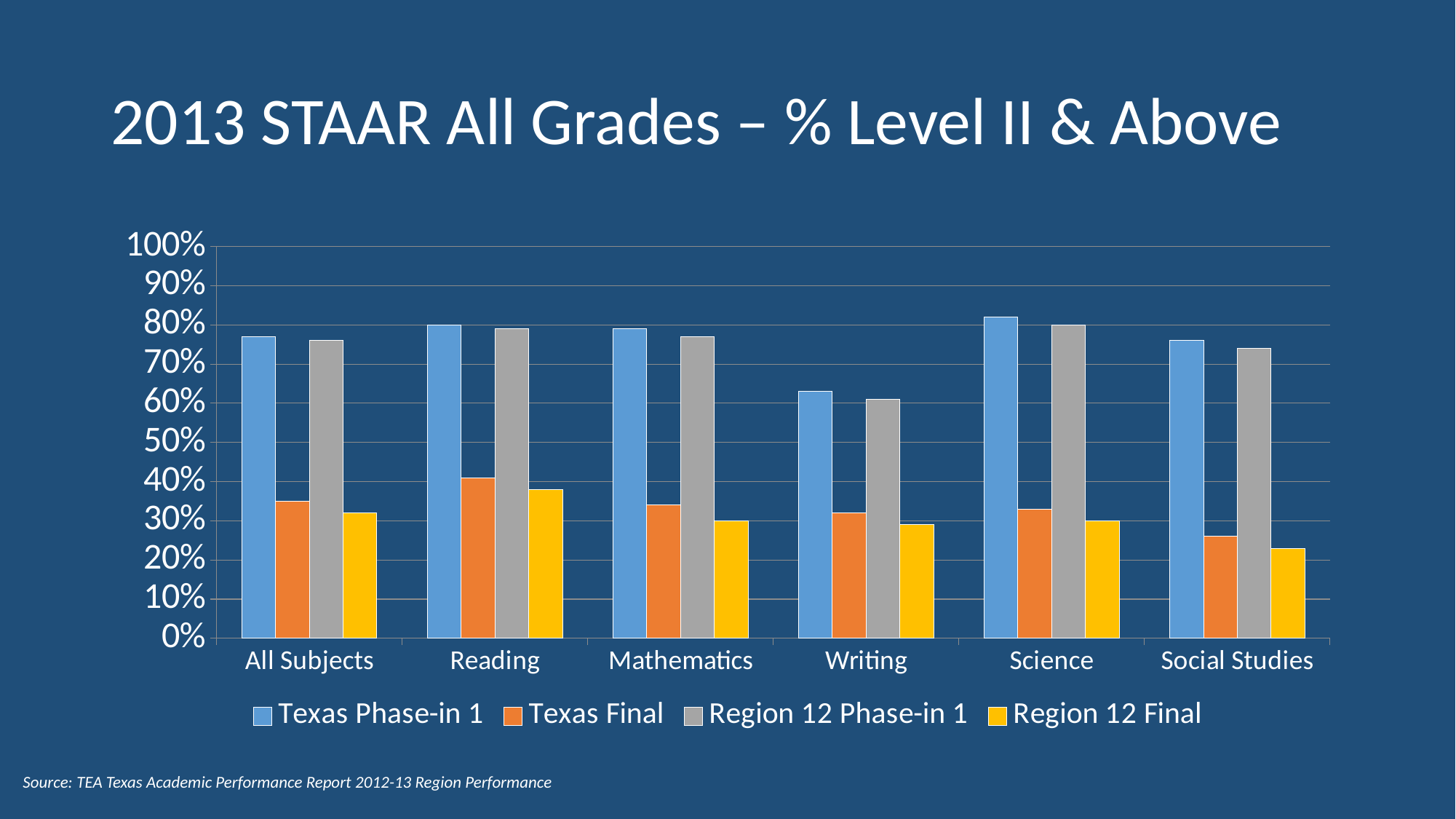
How many subject categories are shown on the x axis? 6 Which subject has the lowest Region 12 Phase-in 1 value? Writing Which subject has the lowest Texas Phase-in 1 value? Writing Which is larger, the Texas Final value for Reading or the Texas Final value for Writing? Reading Which subject has the highest Texas Final value? Reading Which subject has the lowest Region 12 Final value? Social Studies Is the Texas Phase-in 1 value for Writing greater or less than 60%? greater How many series does the legend list? 4 What is the title of the chart? 2013 STAAR All Grades – % Level II & Above Is the Texas Final value for Social Studies greater or less than 30%? less Is the Texas Final value for All Subjects greater or less than 30%? greater What kind of chart is shown on the slide? bar chart